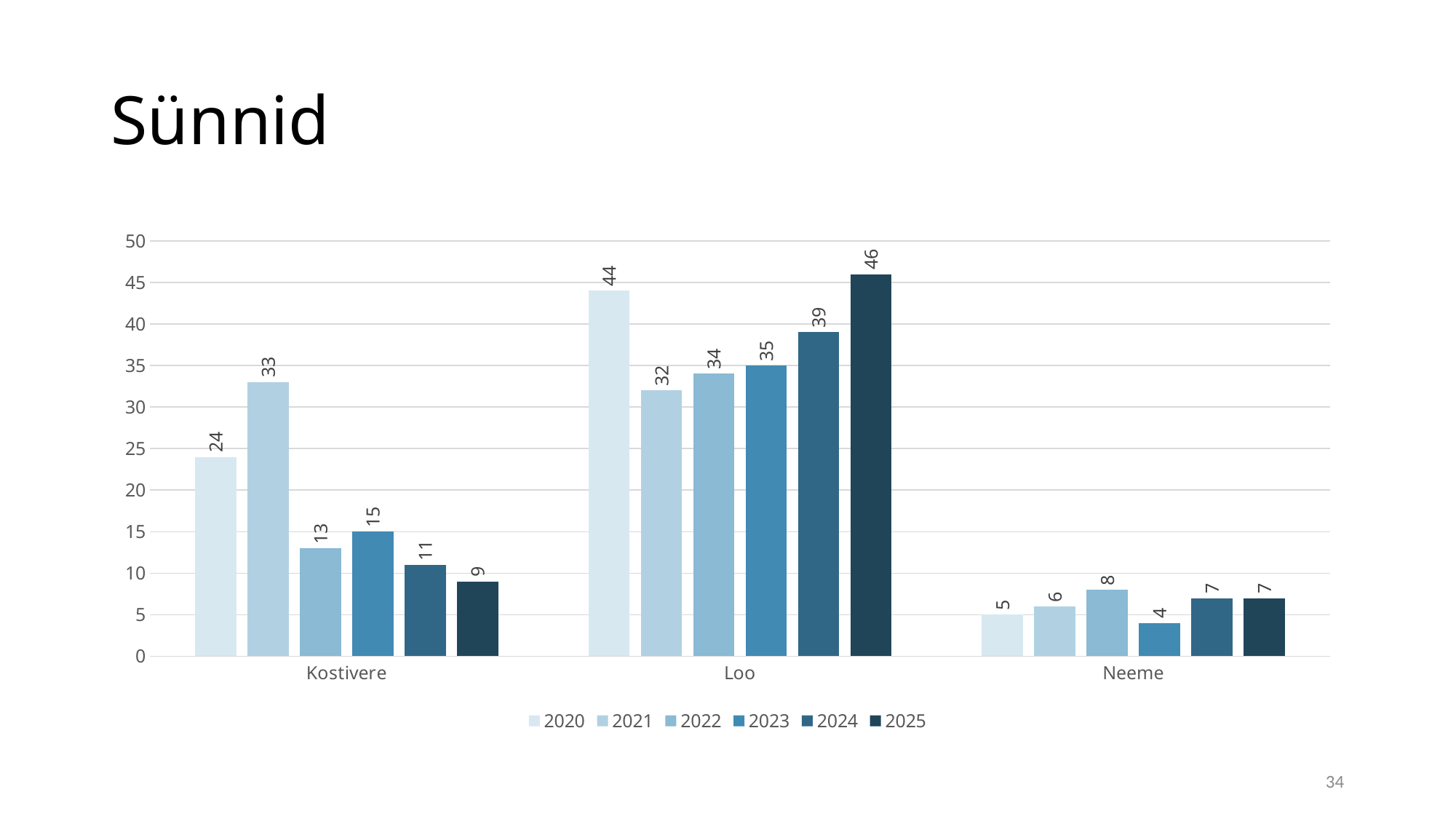
How many categories are shown on the x axis? 3 Which category has the lowest value in 2025? Neeme What kind of chart is shown on the slide? Bar chart Which is larger for Loo: the 2020 value or the 2025 value? 2025 How many series does the legend list? 6 What is the value for Neeme in 2023? 4 What is the difference between the 2020 and 2025 values for Kostivere? 15 Which category has the highest value in 2020? Loo What is the value for Kostivere in 2021? 33 What is the title of the slide? Sünnid Do the values for Loo rise or fall from 2021 to 2025? Rise What is the value for Loo in 2025? 46